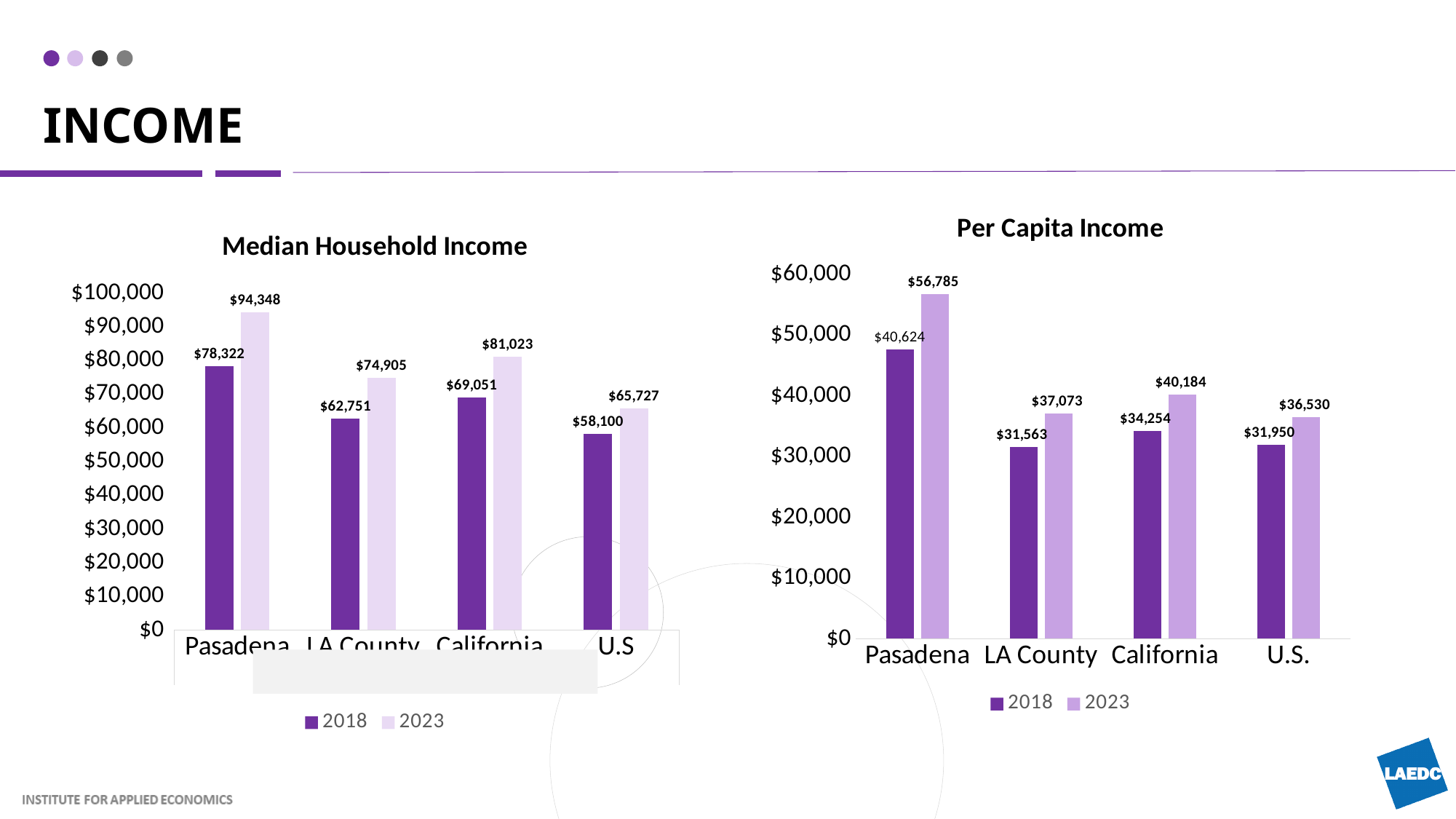
How many categories are shown on the x axis of the Median Household Income chart? 4 In the Per Capita Income chart, what is the 2018 value for U.S.? $31,950 In the Per Capita Income chart, which is larger: the 2023 value for LA County or the 2023 value for U.S.? LA County In the Per Capita Income chart, which category has the lowest 2018 value? LA County In the Per Capita Income chart, what is the 2023 value for California? $40,184 In the Median Household Income chart, what is the 2018 value for LA County? $62,751 In the Median Household Income chart, which category has the highest 2023 value? Pasadena What kind of chart is the Per Capita Income chart? Bar chart How many series does the legend of the Per Capita Income chart list? 2 In the Median Household Income chart, what is the difference between the 2023 and 2018 values for California? $11,972 In the Median Household Income chart, what is the 2023 value for Pasadena? $94,348